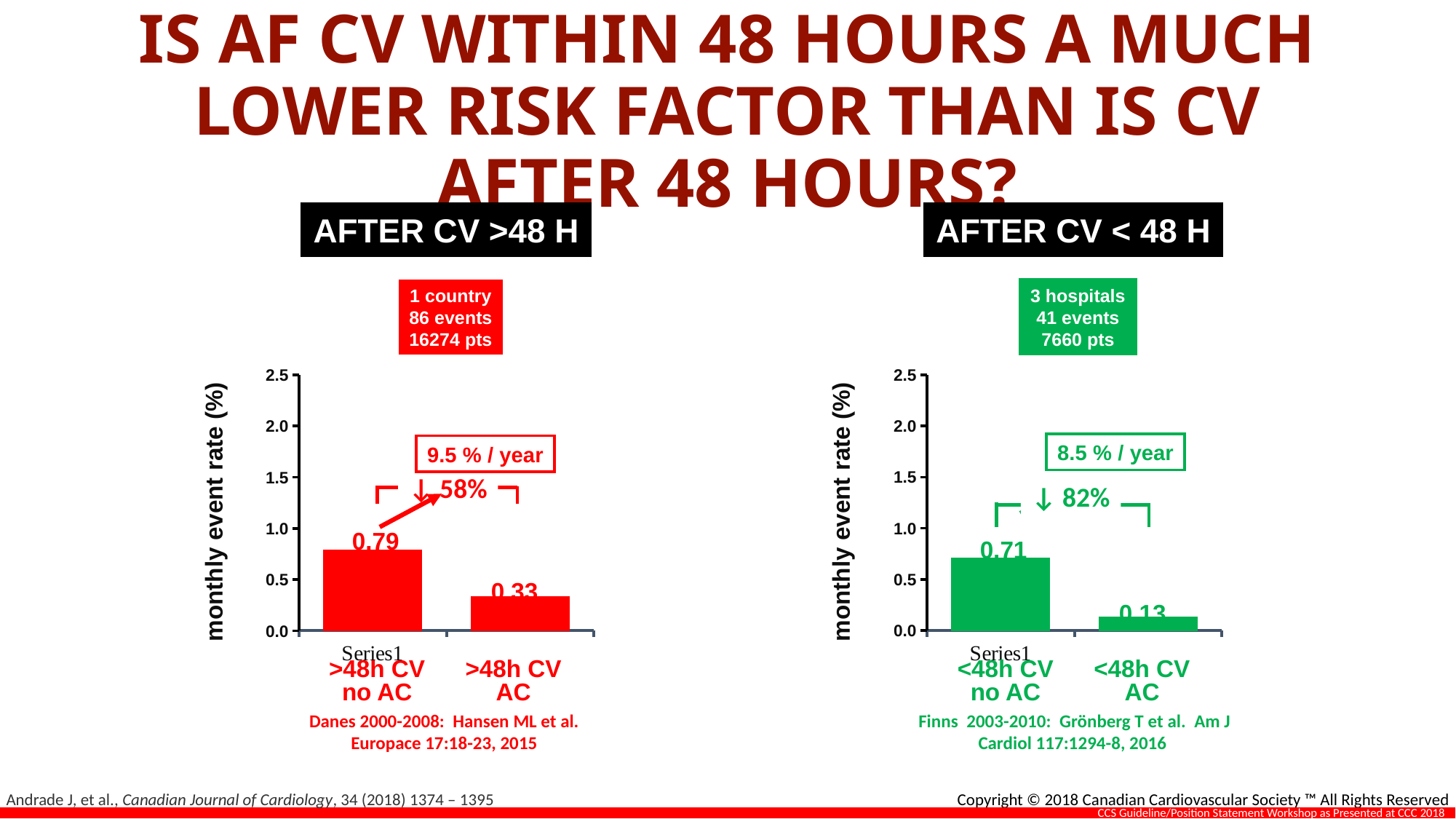
In the "AFTER CV >48 H" chart, what is the monthly event rate for ">48h CV no AC"? 0.79 In the "AFTER CV >48 H" chart, what is the monthly event rate for ">48h CV AC"? 0.33 In the "AFTER CV >48 H" chart, what is the difference in monthly event rate between ">48h CV no AC" and ">48h CV AC"? 0.46 In the "AFTER CV < 48 H" chart, what is the monthly event rate for "<48h CV no AC"? 0.71 How many bars are plotted in the "AFTER CV < 48 H" chart? 2 What type of chart is used in the "AFTER CV >48 H" panel? Bar chart Which is larger: the ">48h CV AC" value in the left chart or the "<48h CV AC" value in the right chart? >48h CV AC In the "AFTER CV < 48 H" chart, which category has the lowest monthly event rate? <48h CV AC In the "AFTER CV < 48 H" chart, what is the difference in monthly event rate between "<48h CV no AC" and "<48h CV AC"? 0.58 In the "AFTER CV >48 H" chart, is the value for ">48h CV no AC" greater or less than 1.0? less In the "AFTER CV >48 H" chart, which category has the higher monthly event rate? >48h CV no AC In the "AFTER CV < 48 H" chart, what is the monthly event rate for "<48h CV AC"? 0.13